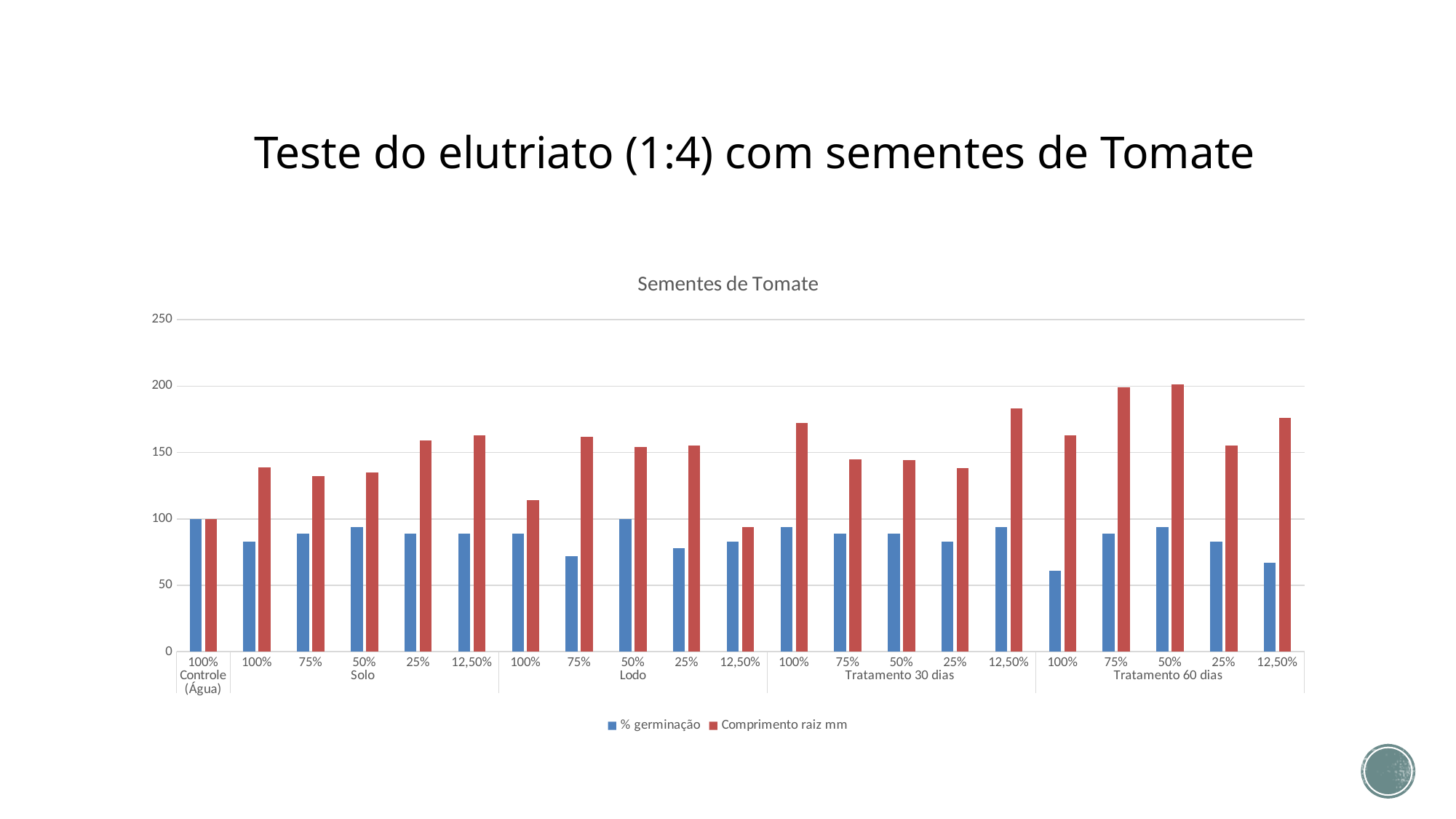
Is the Comprimento raiz mm value for 100% Lodo greater or less than 150? less Is the Comprimento raiz mm value for 12,50% Tratamento 30 dias greater or less than 150? greater Is the % germinação value for 75% Lodo greater or less than 100? less Which series is shown in red? Comprimento raiz mm What is the title of the chart? Sementes de Tomate How many categories are plotted along the x axis? 21 What kind of chart is shown on the slide? bar chart Which has the larger Comprimento raiz mm value, 25% Solo or 75% Solo? 25% Solo Which has the larger % germinação value, 50% Lodo or 75% Lodo? 50% Lodo How many series does the legend list? 2 Which category has the lowest % germinação? 100% Tratamento 60 dias